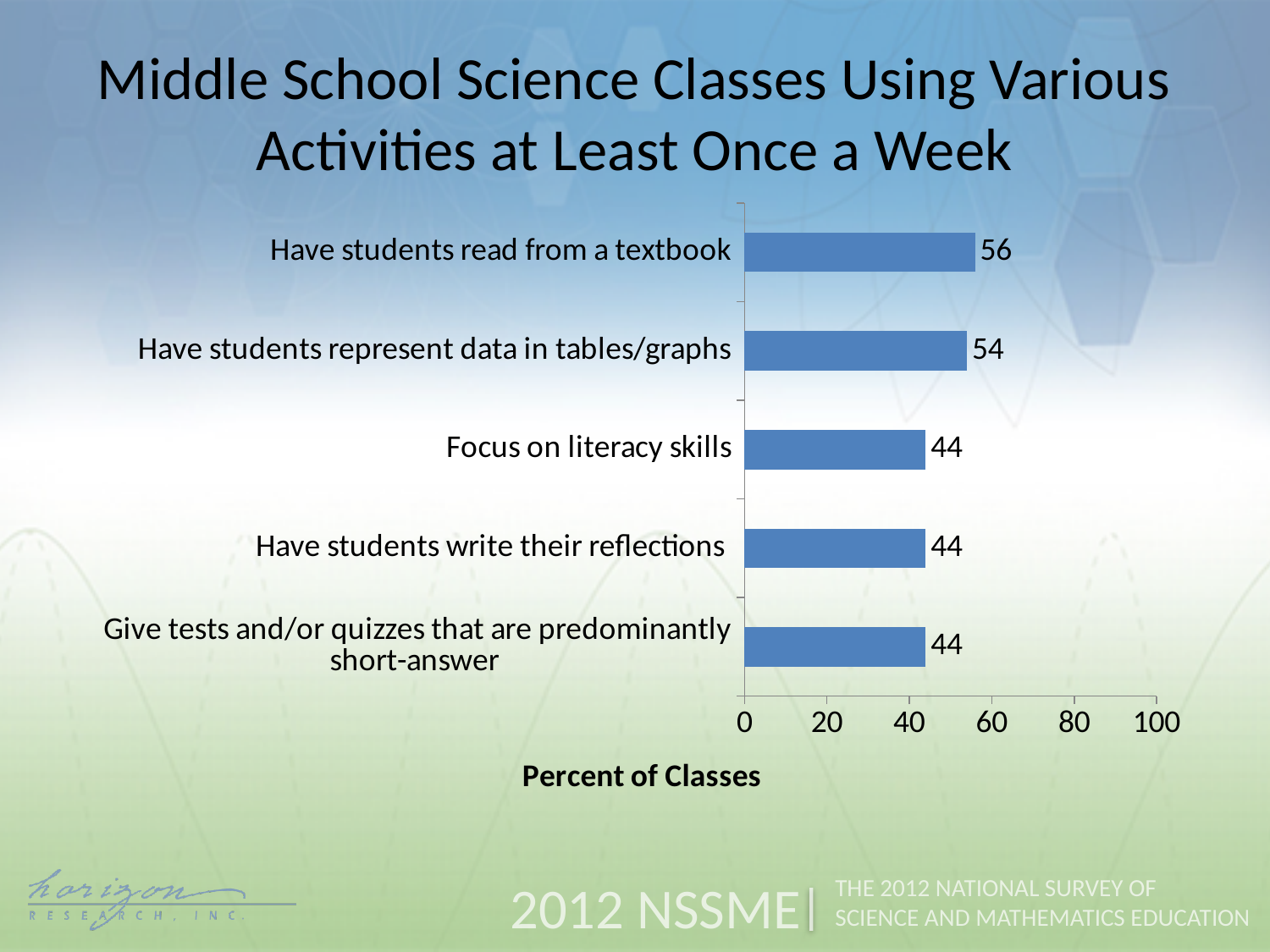
What is the value for 'Focus on literacy skills'? 44 Which is larger: the value for 'Have students represent data in tables/graphs' or 'Focus on literacy skills'? Have students represent data in tables/graphs Which activity has the highest percent of classes? Have students read from a textbook What is the difference between the values for 'Have students read from a textbook' and 'Have students represent data in tables/graphs'? 2 What is the difference between the values for 'Have students read from a textbook' and 'Have students write their reflections'? 12 What kind of chart is shown on the slide? bar chart What percent of classes have students read from a textbook at least once a week? 56 What is the label of the horizontal axis? Percent of Classes What is the value for 'Have students represent data in tables/graphs'? 54 How many activities are shown in the chart? 5 What is the value for 'Give tests and/or quizzes that are predominantly short-answer'? 44 Is the value for 'Have students read from a textbook' greater or less than 40? greater